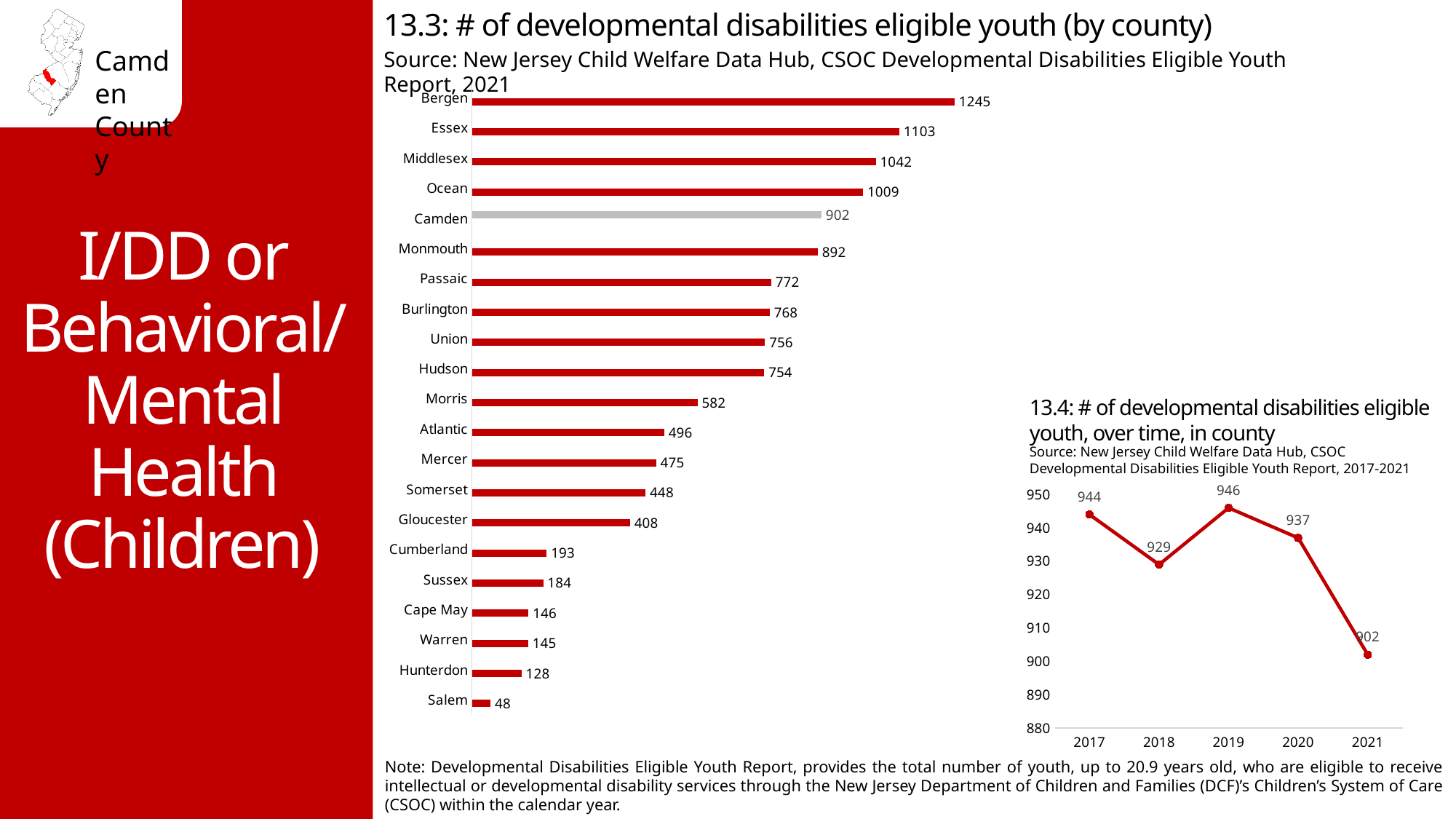
What kind of chart is '13.3: # of developmental disabilities eligible youth (by county)'? Bar chart In the chart '13.4: # of developmental disabilities eligible youth, over time, in county', which year has the lowest value? 2021 In the chart '13.4: # of developmental disabilities eligible youth, over time, in county', what is the value for 2019? 946 In the chart '13.3: # of developmental disabilities eligible youth (by county)', which county has the highest value? Bergen In the chart '13.3: # of developmental disabilities eligible youth (by county)', what is the difference between the values for Bergen and Essex? 142 In the chart '13.3: # of developmental disabilities eligible youth (by county)', what is the value for Camden? 902 What kind of chart is '13.4: # of developmental disabilities eligible youth, over time, in county'? Line chart In the chart '13.3: # of developmental disabilities eligible youth (by county)', which county has the lowest value? Salem In the chart '13.3: # of developmental disabilities eligible youth (by county)', how many counties are shown? 21 In the chart '13.4: # of developmental disabilities eligible youth, over time, in county', what is the difference between the values for 2020 and 2021? 35 In the chart '13.3: # of developmental disabilities eligible youth (by county)', what is the value for Gloucester? 408 In the chart '13.3: # of developmental disabilities eligible youth (by county)', which is larger, the value for Morris or the value for Atlantic? Morris